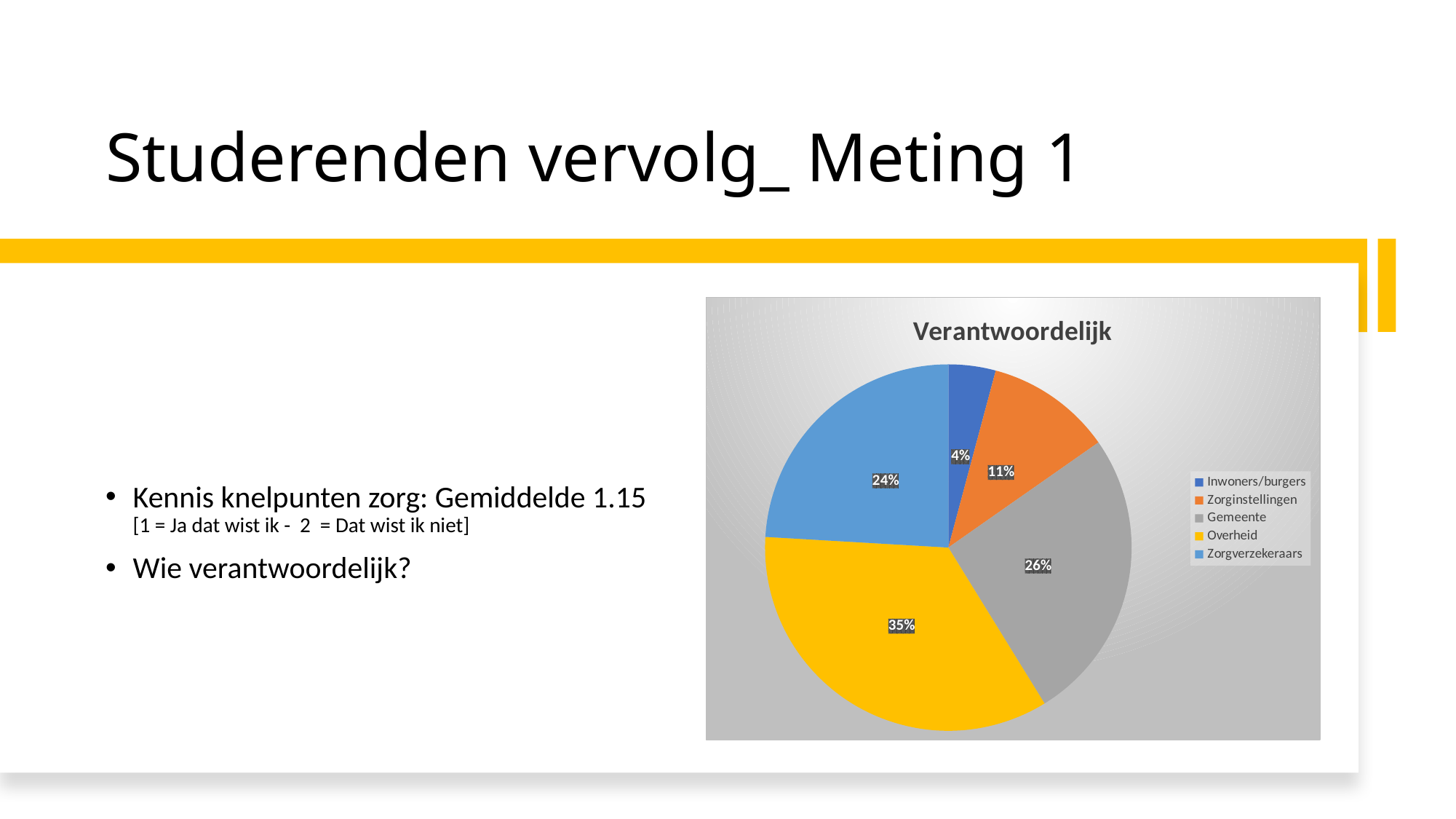
How many categories does the legend list? 5 What share of the pie does Zorginstellingen have? 11% Which category has the smallest share of the pie? Inwoners/burgers What share of the pie does Zorgverzekeraars have? 24% Which has a larger share, Zorgverzekeraars or Zorginstellingen? Zorgverzekeraars What kind of chart is shown on the slide? pie chart What share of the pie does Overheid have? 35% What share of the pie does Inwoners/burgers have? 4% What is the title of the chart? Verantwoordelijk What is the difference in percentage points between Overheid and Gemeente? 9 Which category has the largest share of the pie? Overheid What share of the pie does Gemeente have? 26%